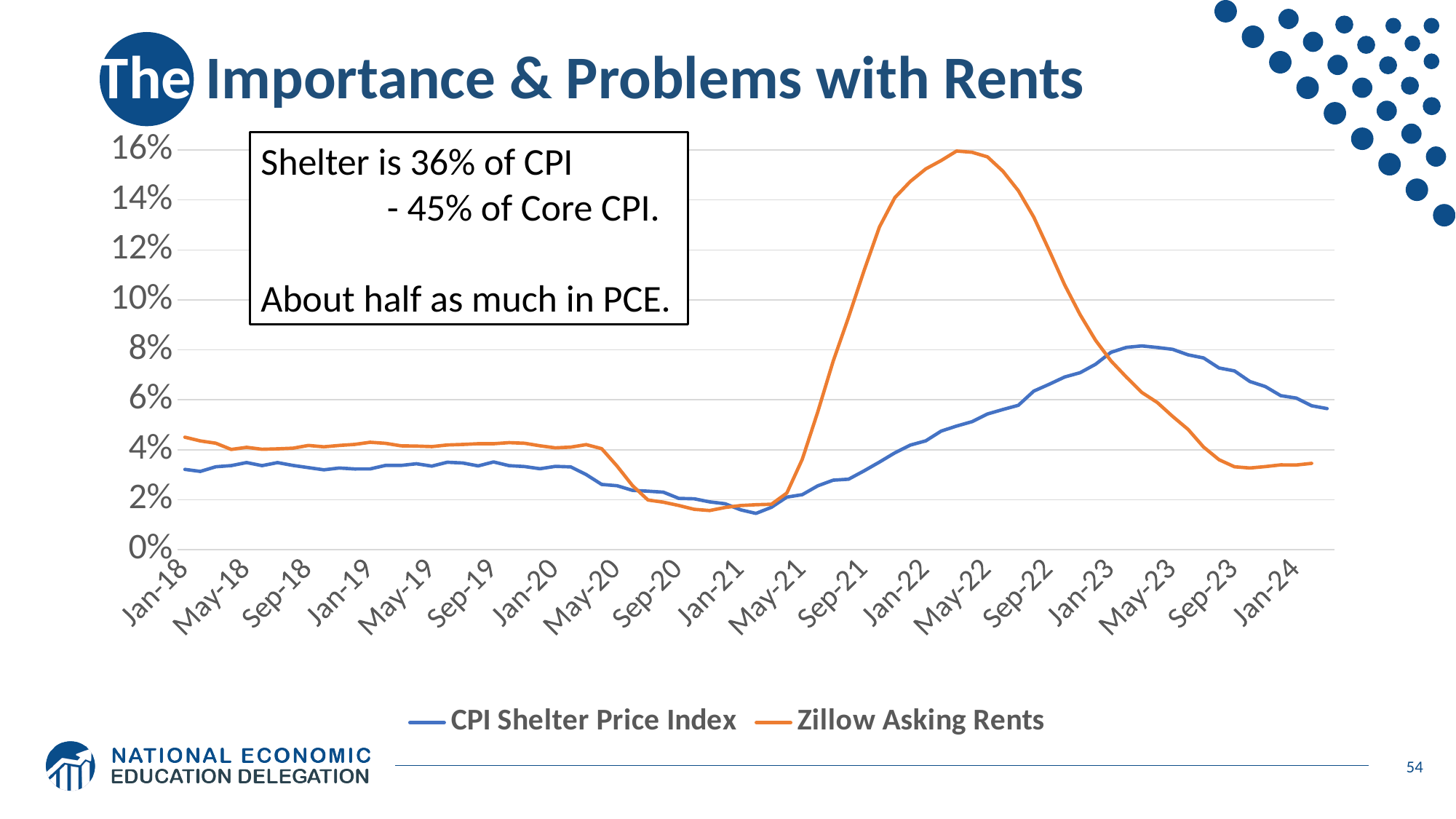
Is the value for CPI Shelter Price Index at Jan-18 greater or less than 4%? less At Jan-19, which series has the higher value, CPI Shelter Price Index or Zillow Asking Rents? Zillow Asking Rents Which colour is used for the Zillow Asking Rents line? Orange What kind of chart is shown on the slide? Line chart Which series reaches the highest value on the chart? Zillow Asking Rents At May-23, which series has the higher value, CPI Shelter Price Index or Zillow Asking Rents? CPI Shelter Price Index Is the value for Zillow Asking Rents at May-22 greater or less than 14%? greater How many series does the legend list? 2 Is the value for CPI Shelter Price Index at Jan-23 greater or less than 6%? greater What are the two series named in the legend? CPI Shelter Price Index and Zillow Asking Rents Does the Zillow Asking Rents line rise or fall between May-22 and Sep-23? Fall How many date labels are shown on the x axis? 19